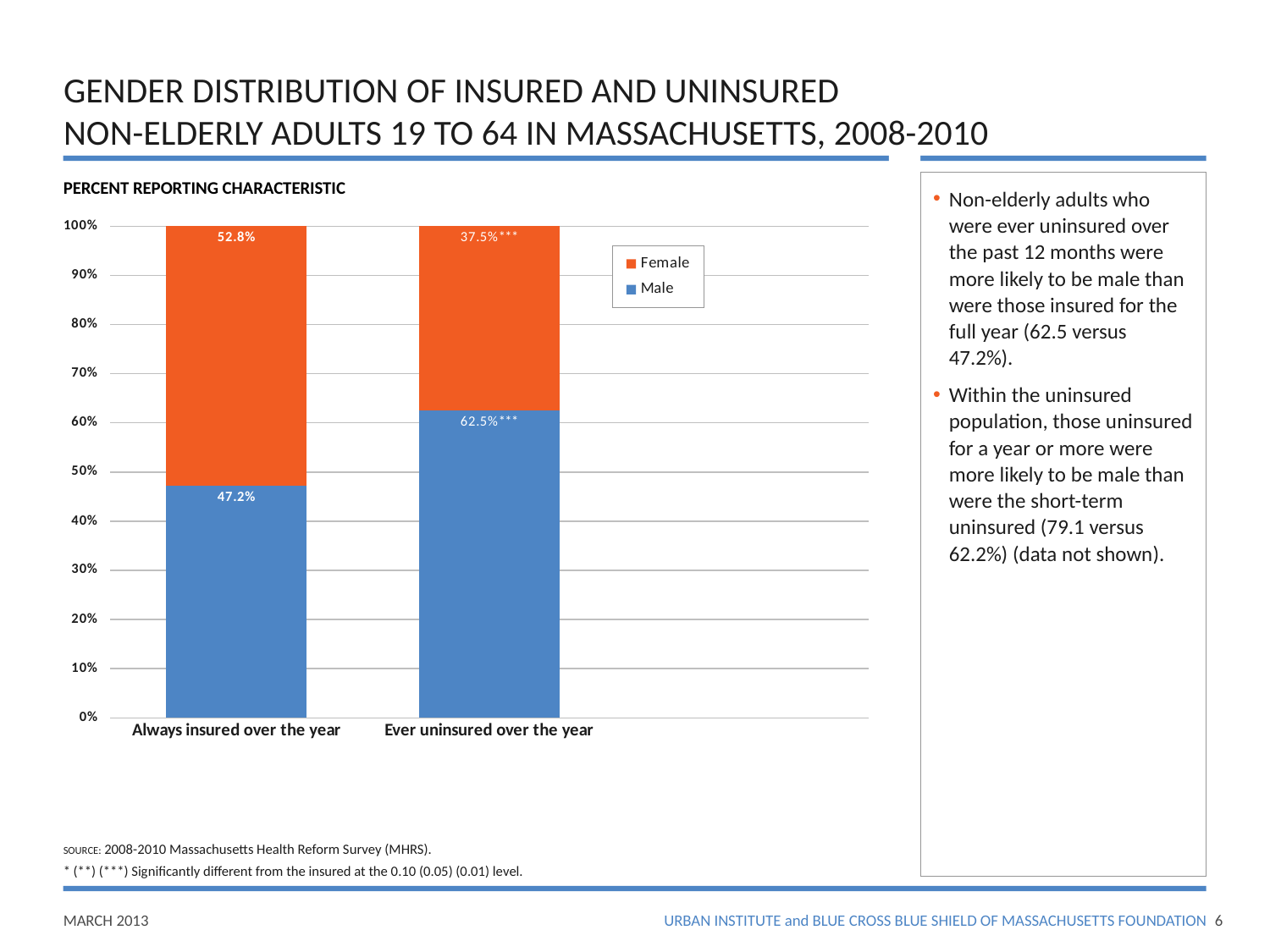
What is the Male value for 'Always insured over the year'? 47.2% What is the Female value for 'Always insured over the year'? 52.8% What kind of chart is shown on the slide? Stacked bar chart What is the Male value for 'Ever uninsured over the year'? 62.5% Which category has the lower Female share? Ever uninsured over the year How many series does the legend list? 2 Which category has the higher Male share? Ever uninsured over the year Which colour represents Male in the chart? Blue Is the Female value larger for 'Always insured over the year' or 'Ever uninsured over the year'? Always insured over the year What is the difference between the Male values for 'Ever uninsured over the year' and 'Always insured over the year'? 15.3% What is the Female value for 'Ever uninsured over the year'? 37.5% How many categories are shown on the x axis? 2